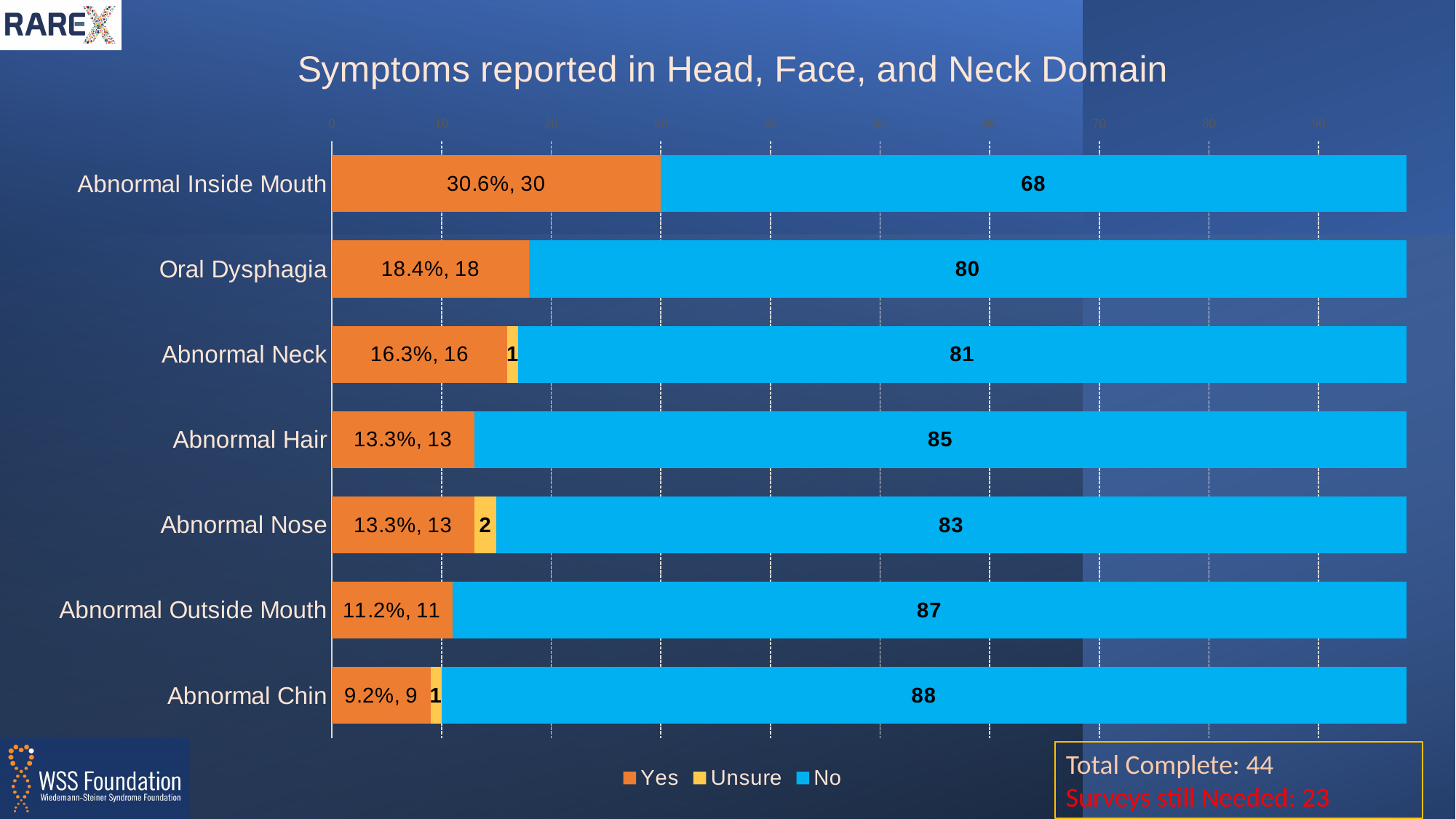
What is the title of the chart? Symptoms reported in Head, Face, and Neck Domain What is the 'No' value for Oral Dysphagia? 80 What is the 'Unsure' value for Abnormal Nose? 2 What is the 'Yes' data label for Abnormal Inside Mouth? 30.6%, 30 What is the total of the stacked bar for Abnormal Neck? 98 Which symptom has the lowest 'Yes' count? Abnormal Chin What is the difference between the 'No' values for Abnormal Chin and Abnormal Inside Mouth? 20 Which symptom has the highest 'Yes' count? Abnormal Inside Mouth How many symptom categories are shown in the chart? 7 Which has a larger 'No' value, Abnormal Hair or Abnormal Nose? Abnormal Hair What kind of chart is shown on the slide? Stacked bar chart How many series does the legend list? 3